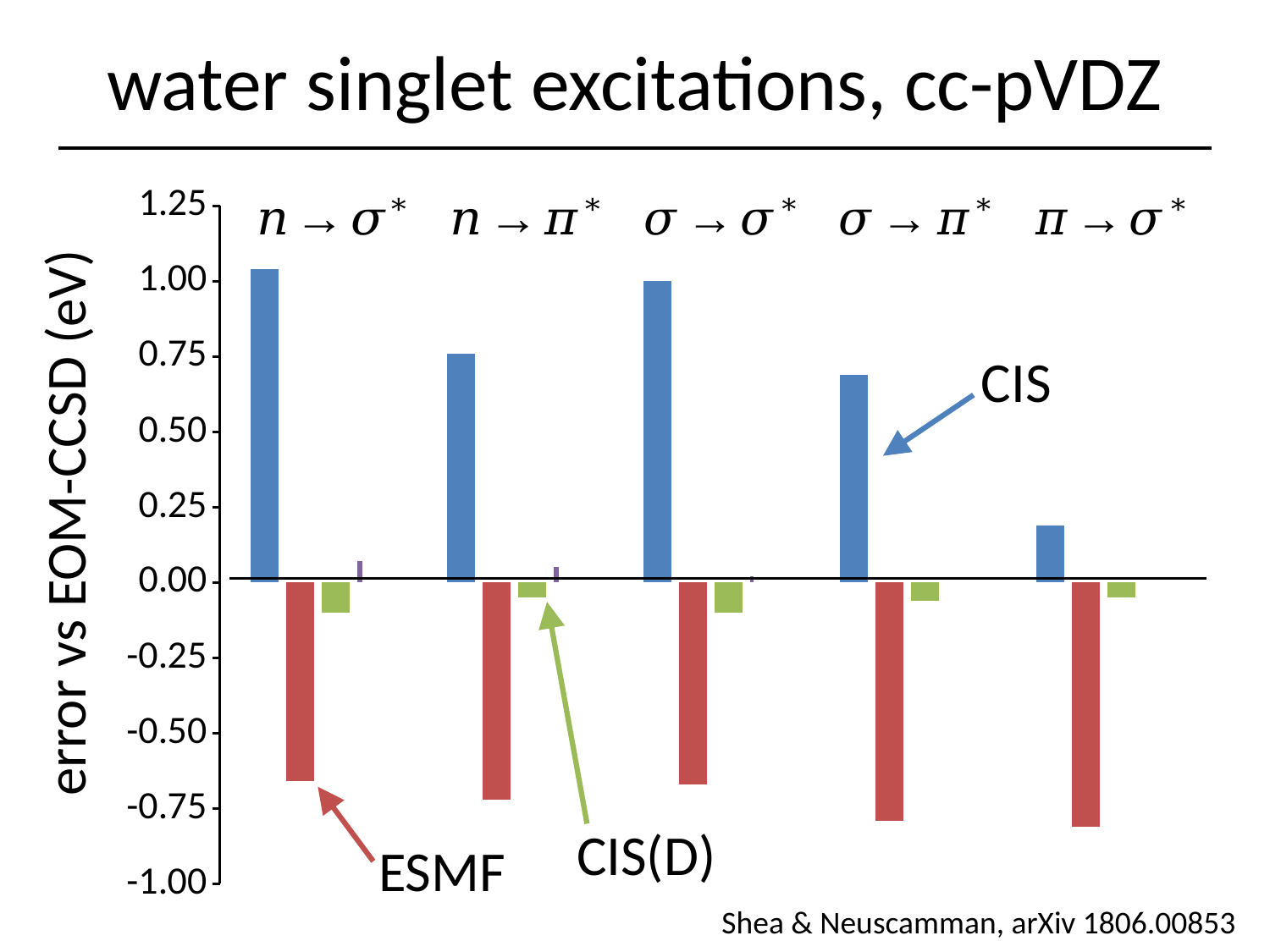
Which is larger, the CIS value for n → σ* or the CIS value for π → σ*? n → σ* Which is larger, the CIS value for n → π* or the CIS value for σ → π*? n → π* Is the CIS value for σ → σ* greater or less than 0.75? greater Is the ESMF value for σ → π* greater or less than -0.75? less How many excitation categories are shown along the x axis? 5 Which category has the lowest CIS error? π → σ* What kind of chart is shown on the slide? bar chart Is the CIS value for π → σ* greater or less than 0.25? less What is the label of the y axis? error vs EOM-CCSD (eV) What is the title of the chart? water singlet excitations, cc-pVDZ